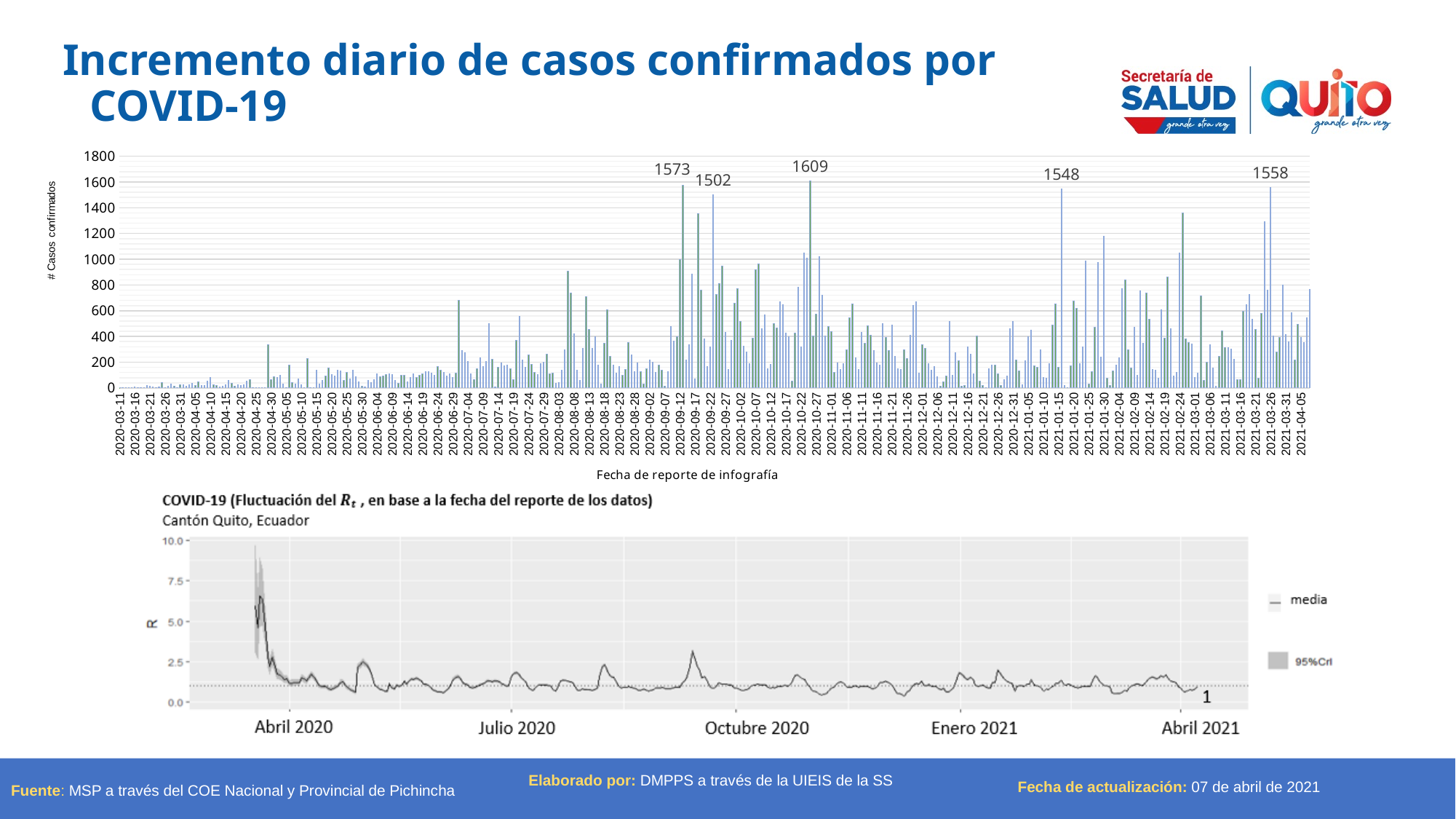
In the bottom chart, what location is given in the subtitle under the chart title? Cantón Quito, Ecuador In the top chart, which labeled peak is larger, 1573 or 1558? 1573 In the bottom chart (COVID-19 Fluctuación del Rt), how many entries does the legend list? 2 In the top chart, what is the difference between the labeled peaks 1573 and 1502? 71 In the top chart, what is the difference between the labeled peaks 1609 and 1573? 36 In the top chart, what is the difference between the labeled peaks 1558 and 1548? 10 In the bottom chart (COVID-19 Fluctuación del Rt), what kind of chart is shown? line chart In the top chart, what is the maximum value shown on the vertical axis? 1800 In the top chart, what kind of chart is used to show the daily confirmed cases? bar chart In the top chart, what is the lowest of the five labeled peak values? 1502 In the bottom chart (COVID-19 Fluctuación del Rt), does the Rt line rise or fall between Abril 2020 and Julio 2020? fall In the top chart, what is the highest data label shown? 1609